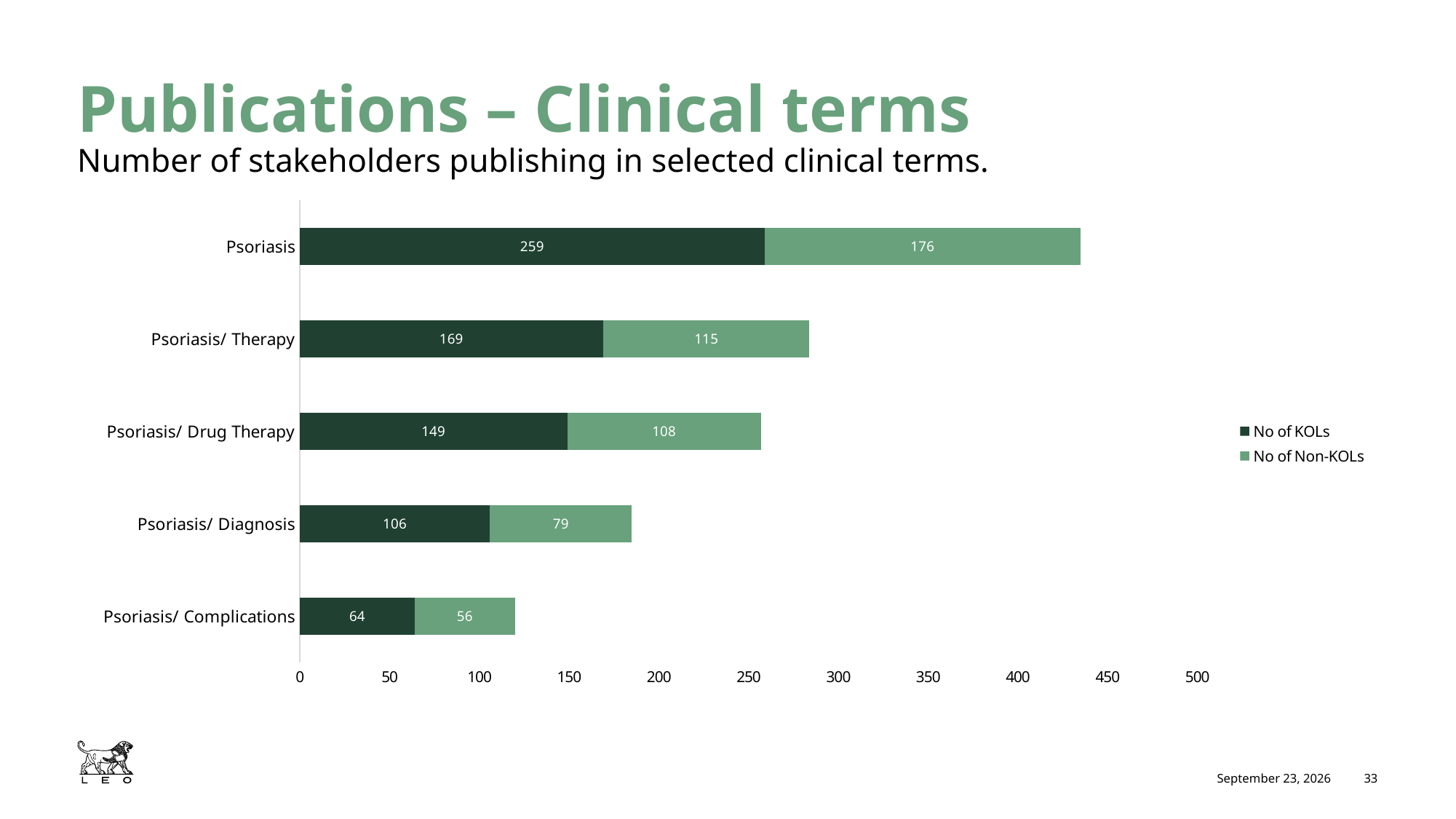
What kind of chart is shown on the slide? Stacked bar chart Is the total stacked bar for Psoriasis/ Therapy greater or less than 250? greater Which clinical term has the lowest number of Non-KOLs? Psoriasis/ Complications Which series is shown in the darker green colour? No of KOLs Which is larger for Psoriasis/ Drug Therapy: the number of KOLs or the number of Non-KOLs? No of KOLs How many clinical terms are shown on the chart? 5 What is the number of KOLs for Psoriasis/ Therapy? 169 How many series does the legend list? 2 What is the difference between the number of KOLs and Non-KOLs for Psoriasis? 83 What is the number of Non-KOLs for Psoriasis/ Diagnosis? 79 Which clinical term has the highest number of KOLs? Psoriasis What is the total number of stakeholders for Psoriasis/ Complications? 120